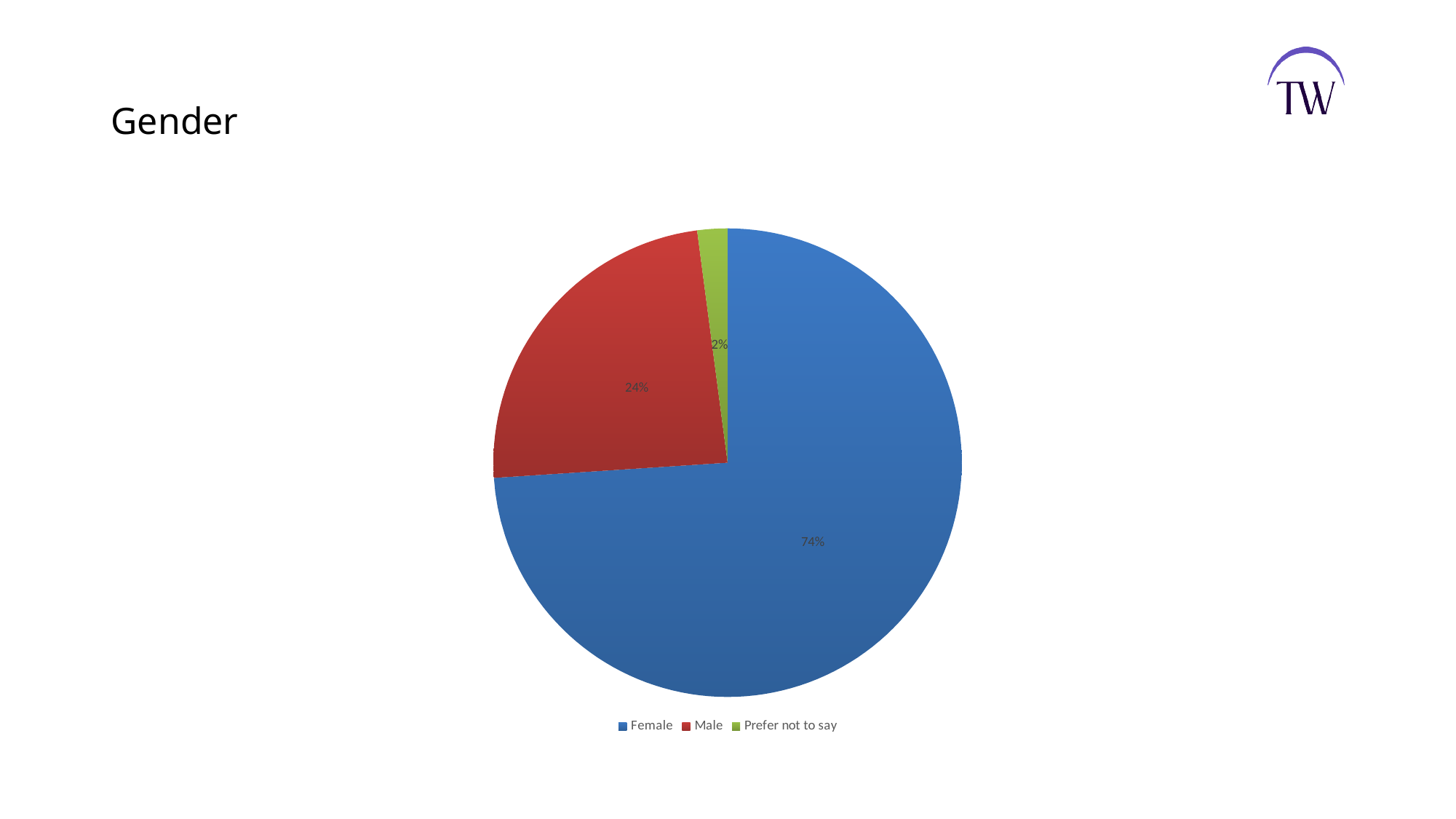
What share of the pie does Prefer not to say represent? 2% Which is larger, the Male slice or the Prefer not to say slice? Male What colour is the Male slice? red Which category has the smallest slice of the pie? Prefer not to say What is the difference in percentage points between the Female and Male slices? 50 What is the title of the slide? Gender How many categories does the pie chart show? 3 What share of the pie does Male represent? 24% What is the difference in percentage points between the Male and Prefer not to say slices? 22 What kind of chart is shown on the slide? pie chart Which category has the largest slice of the pie? Female What share of the pie does Female represent? 74%